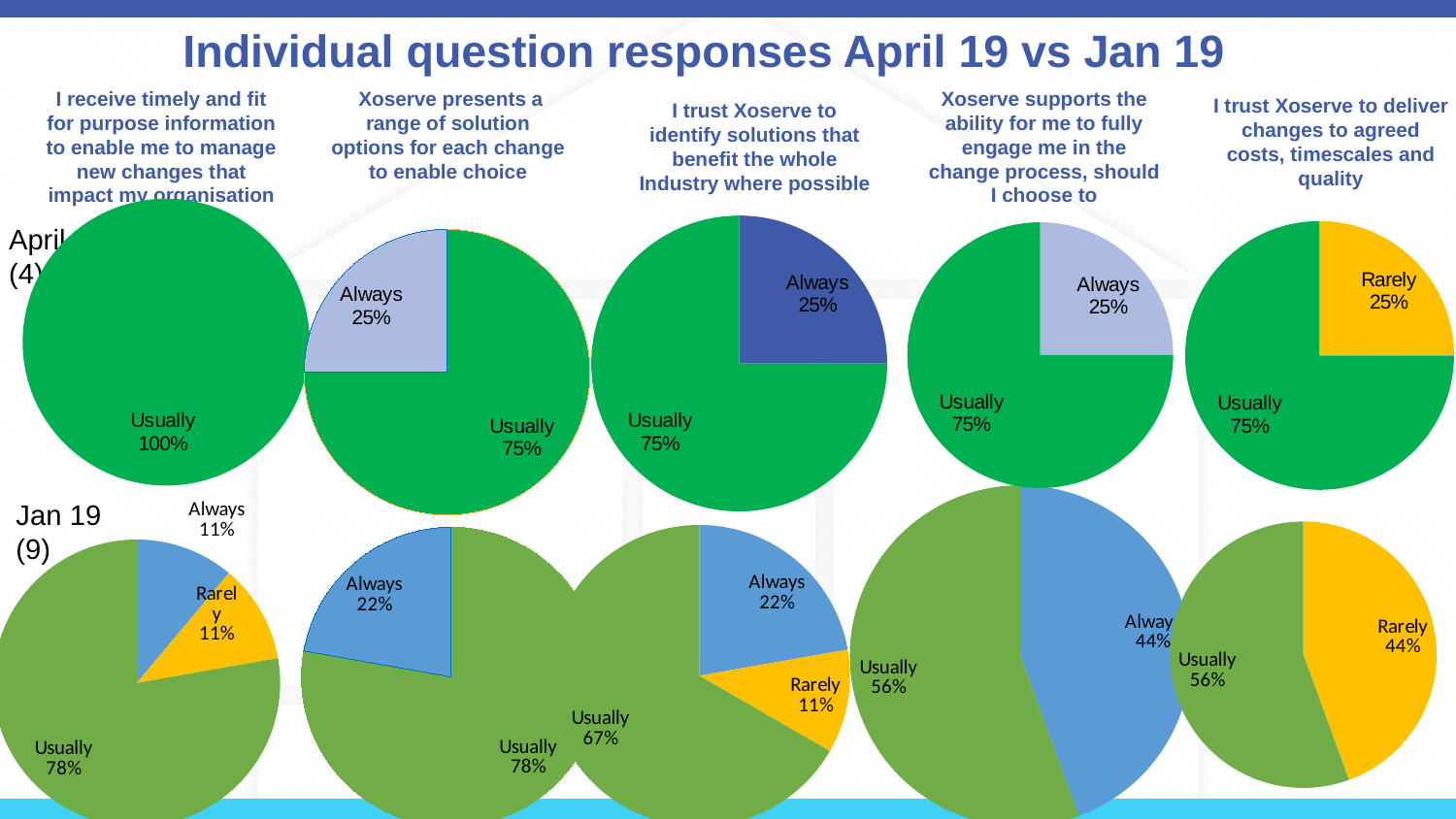
In the April 19 pie chart for "Xoserve presents a range of solution options for each change to enable choice", what share is labelled Always? 25% What kind of charts are shown on the slide? Pie charts In the Jan 19 pie chart for "Xoserve supports the ability for me to fully engage me in the change process, should I choose to", what is the difference between the Usually and Always shares? 12% In the Jan 19 pie chart for "Xoserve supports the ability for me to fully engage me in the change process, should I choose to", what share is labelled Always? 44% In the Jan 19 pie chart for "I trust Xoserve to identify solutions that benefit the whole Industry where possible", which slice is the largest? Usually In the Jan 19 pie chart for "I receive timely and fit for purpose information to enable me to manage new changes that impact my organisation", how many slices does the pie have? 3 In the April 19 pie chart for "I trust Xoserve to deliver changes to agreed costs, timescales and quality", what share is labelled Rarely? 25% In the Jan 19 pie chart for "I trust Xoserve to deliver changes to agreed costs, timescales and quality", which is larger, the Usually slice or the Rarely slice? Usually